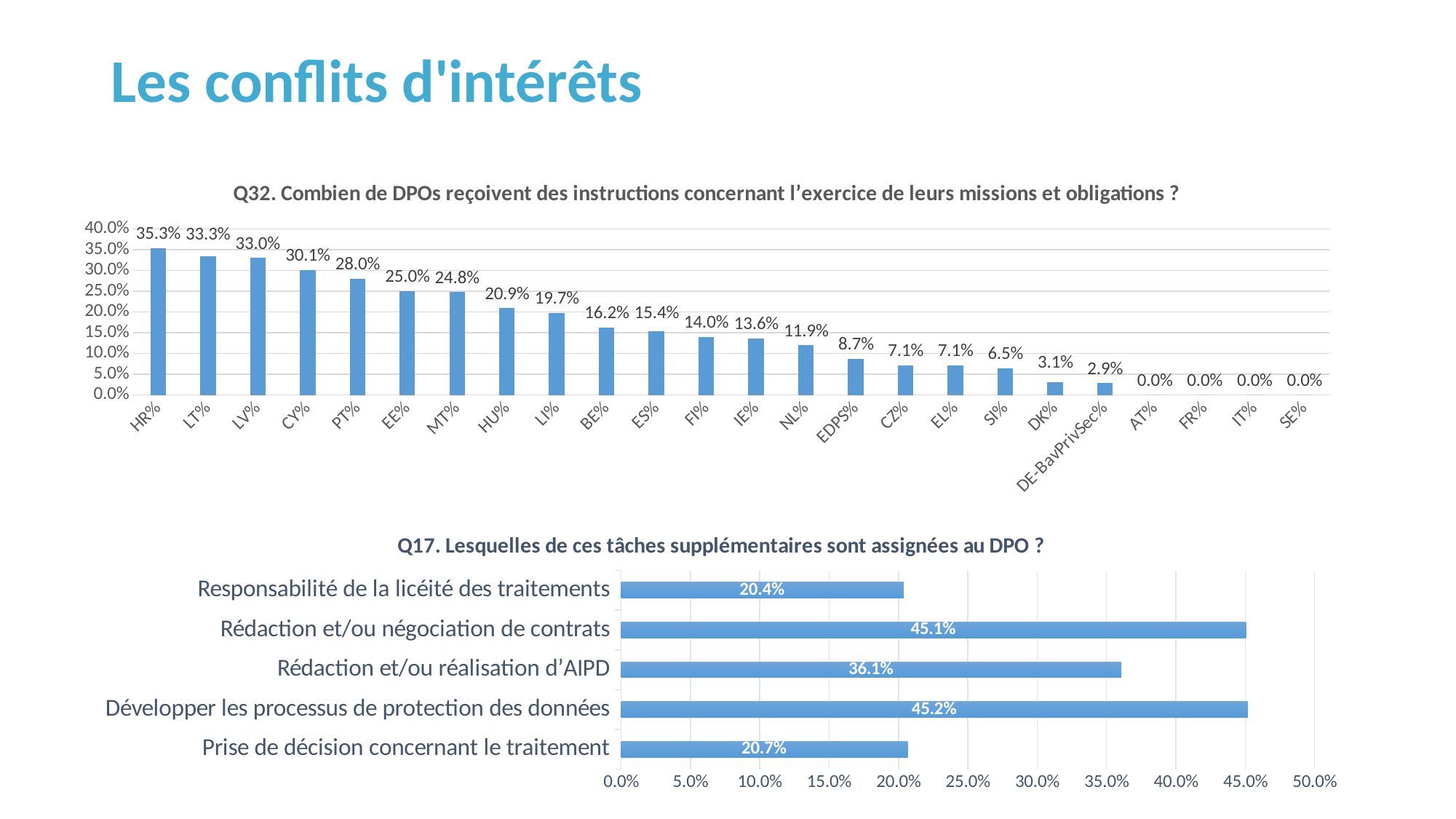
In the Q17 chart, what is the difference between 'Rédaction et/ou négociation de contrats' and 'Responsabilité de la licéité des traitements'? 24.7% In the Q17 chart, what is the value for 'Rédaction et/ou réalisation d'AIPD'? 36.1% In the Q17 chart, how many categories are shown? 5 In the Q32 chart, what is the value for NL%? 11.9% In the Q32 chart, which is larger, the value for HU% or the value for BE%? HU% In the Q32 chart, what is the value for HR%? 35.3% In the Q32 chart, what is the difference between the values for LT% and CY%? 3.2% In the Q32 chart, what is the value for DE-BavPrivSec%? 2.9% In the Q32 chart, how many categories are shown on the x axis? 24 In the Q32 chart, which category has the highest value? HR% What kind of chart is the Q17 chart at the bottom of the slide? bar chart In the Q32 chart, do the values rise or fall from left to right along the x axis? fall